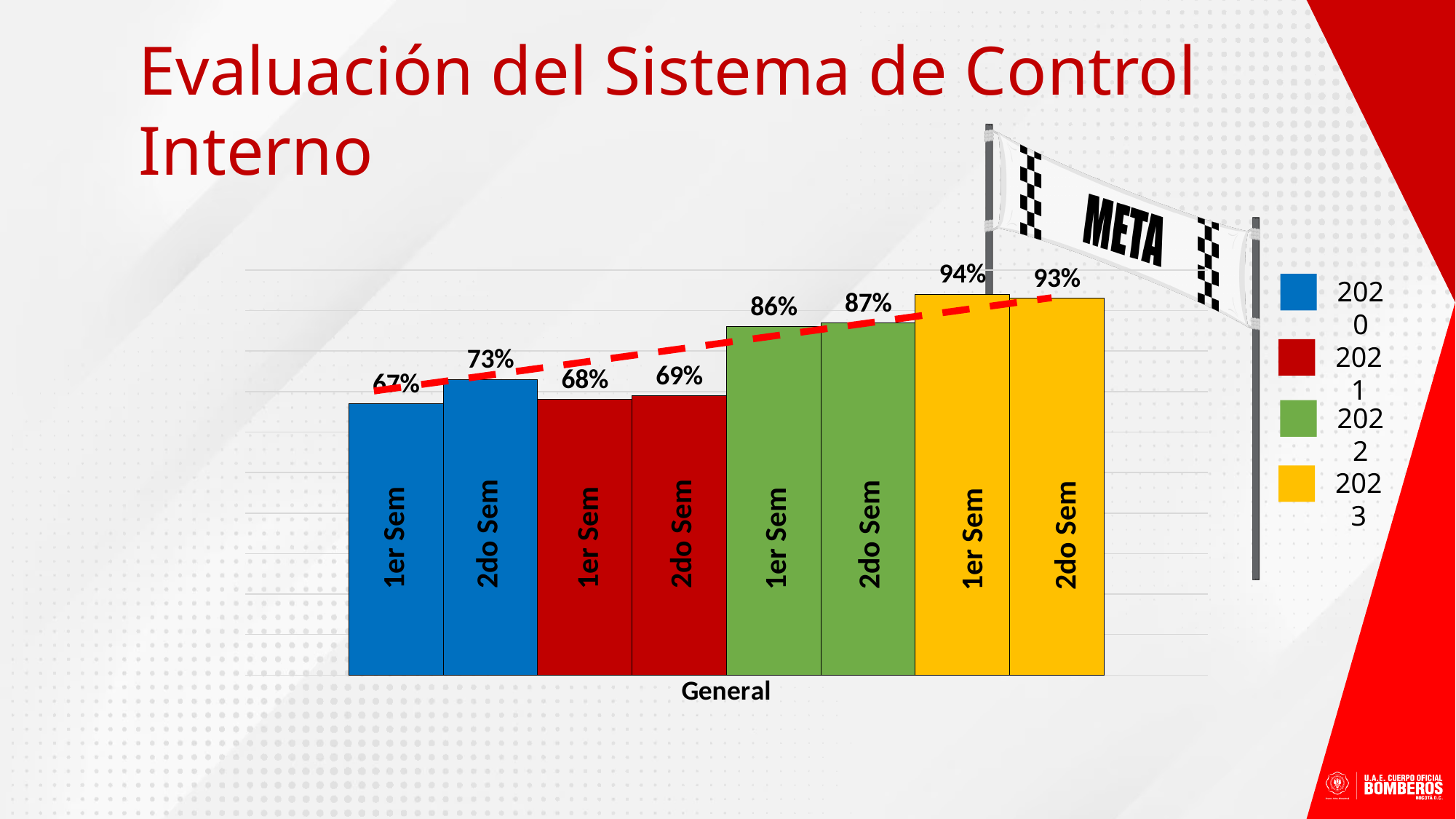
What is the value for 1er Sem 2023? 94% What is the difference between 2do Sem 2020 and 1er Sem 2021? 5% What is the value for 1er Sem 2020? 67% What colour are the bars for 2022 in the chart? Green How many bars are plotted in the chart? 8 What is the difference between 1er Sem 2022 and 2do Sem 2021? 17% Which bar has the lowest value? 1er Sem 2020 How many series does the legend list? 4 What kind of chart is shown on the slide? Bar chart Which is larger, 2do Sem 2020 or 2do Sem 2021? 2do Sem 2020 What is the value for 2do Sem 2022? 87% Which bar has the highest value? 1er Sem 2023